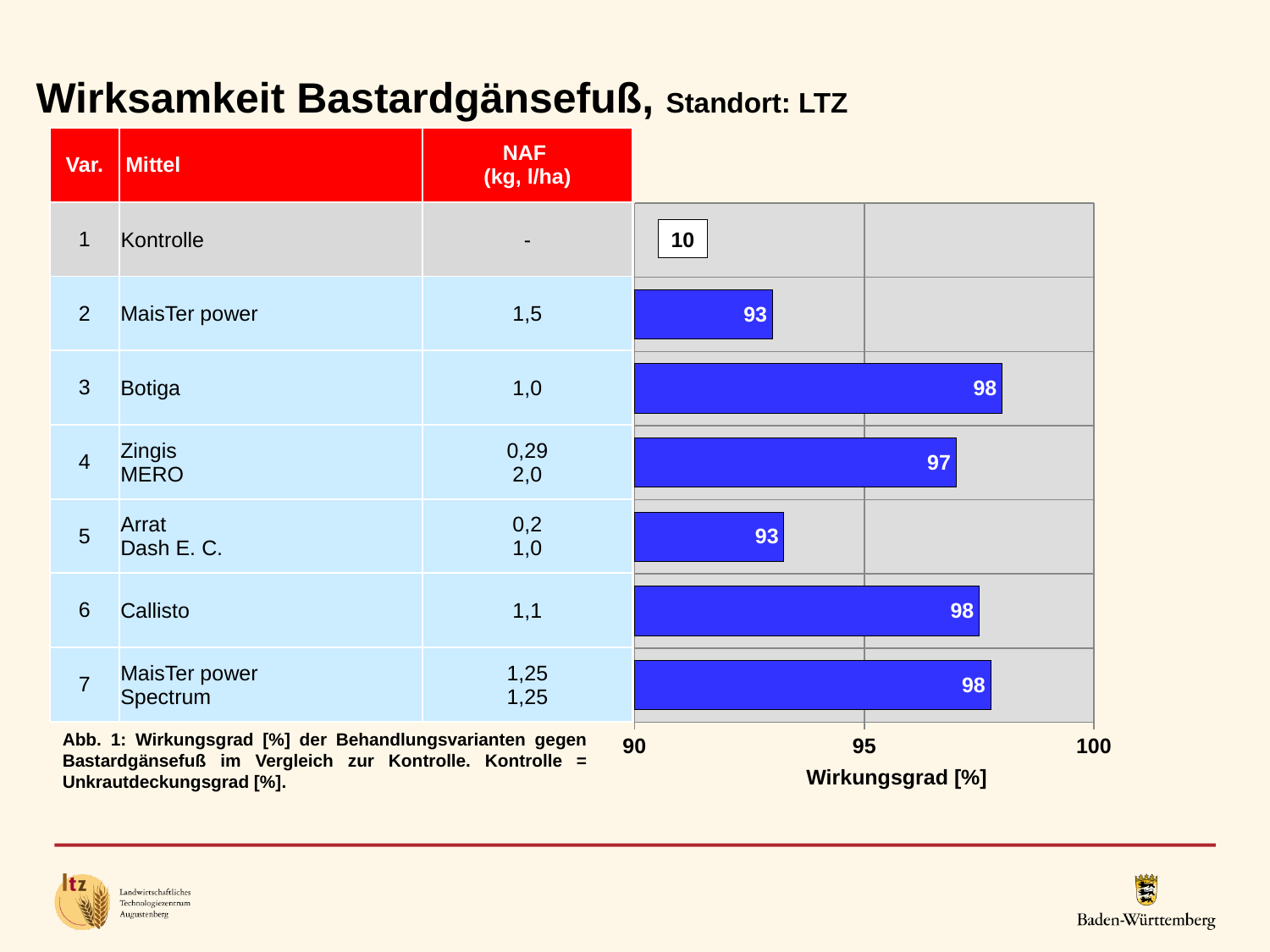
What is the Wirkungsgrad value shown for Botiga (Var. 3)? 98 What kind of chart is shown on the slide? bar chart What is the Wirkungsgrad value for Zingis + MERO (Var. 4)? 97 What is the difference between the Wirkungsgrad of Botiga and MaisTer power (Var. 2)? 5 What is the highest Wirkungsgrad value shown in the chart? 98 How many variants (rows) are shown in the chart? 7 What value is shown for the Kontrolle (Var. 1) row in the chart? 10 What is the label of the horizontal axis of the chart? Wirkungsgrad [%] Which has the higher Wirkungsgrad, Botiga or Zingis + MERO? Botiga What is the Wirkungsgrad value shown for MaisTer power (Var. 2)? 93 Is the value for Arrat + Dash E. C. greater or less than 95? less